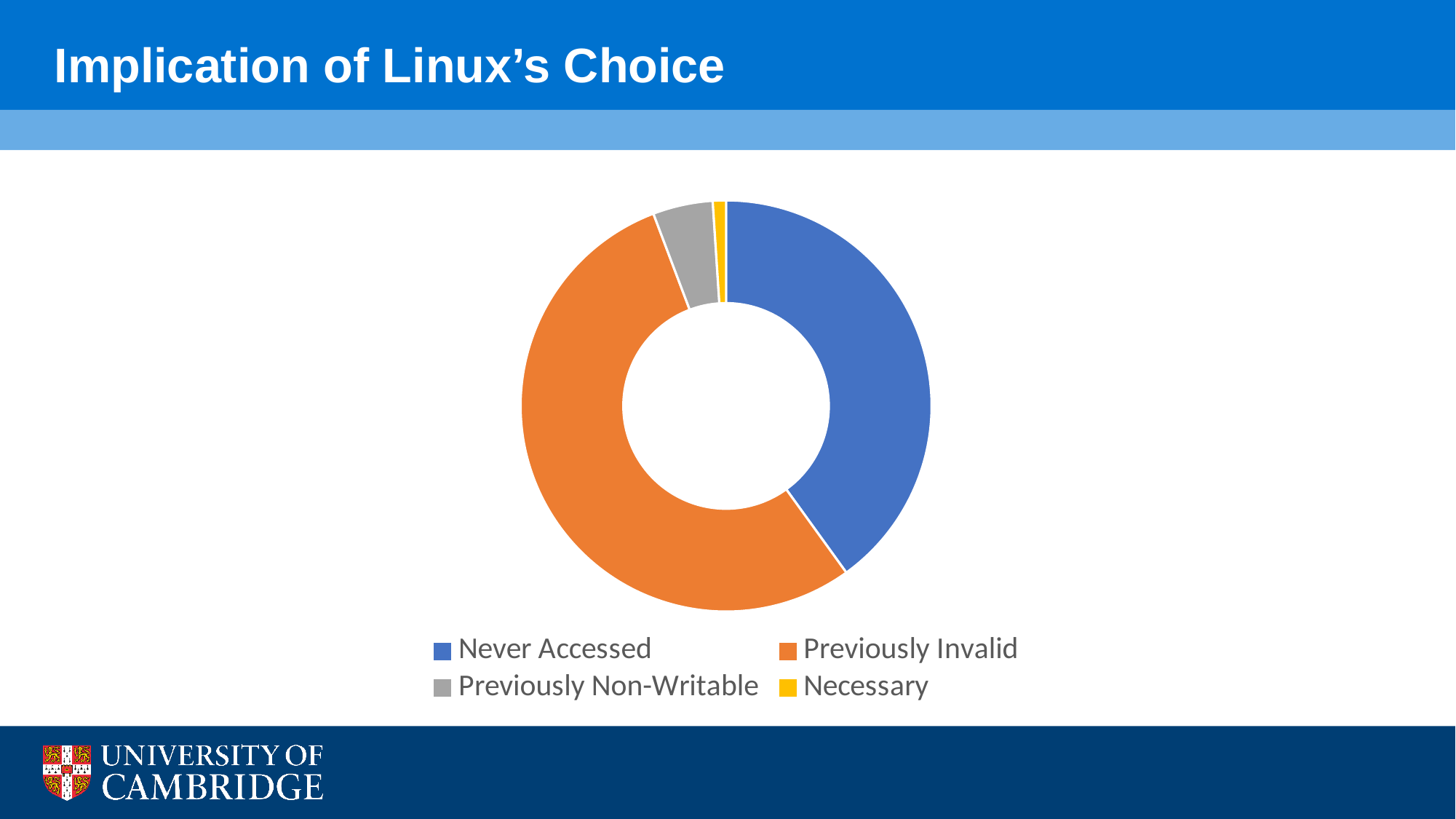
What kind of chart is shown on the slide? Doughnut chart Which is larger: the share for Never Accessed or the share for Previously Non-Writable? Never Accessed Which category takes up the smallest share of the doughnut chart? Necessary Which is larger: the share for Previously Non-Writable or the share for Necessary? Previously Non-Writable What colour represents the Necessary category in the chart? Yellow Which is larger: the share for Previously Invalid or the share for Never Accessed? Previously Invalid How many categories does the chart's legend list? 4 Which category takes up the largest share of the doughnut chart? Previously Invalid Which category is shown in orange in the chart? Previously Invalid